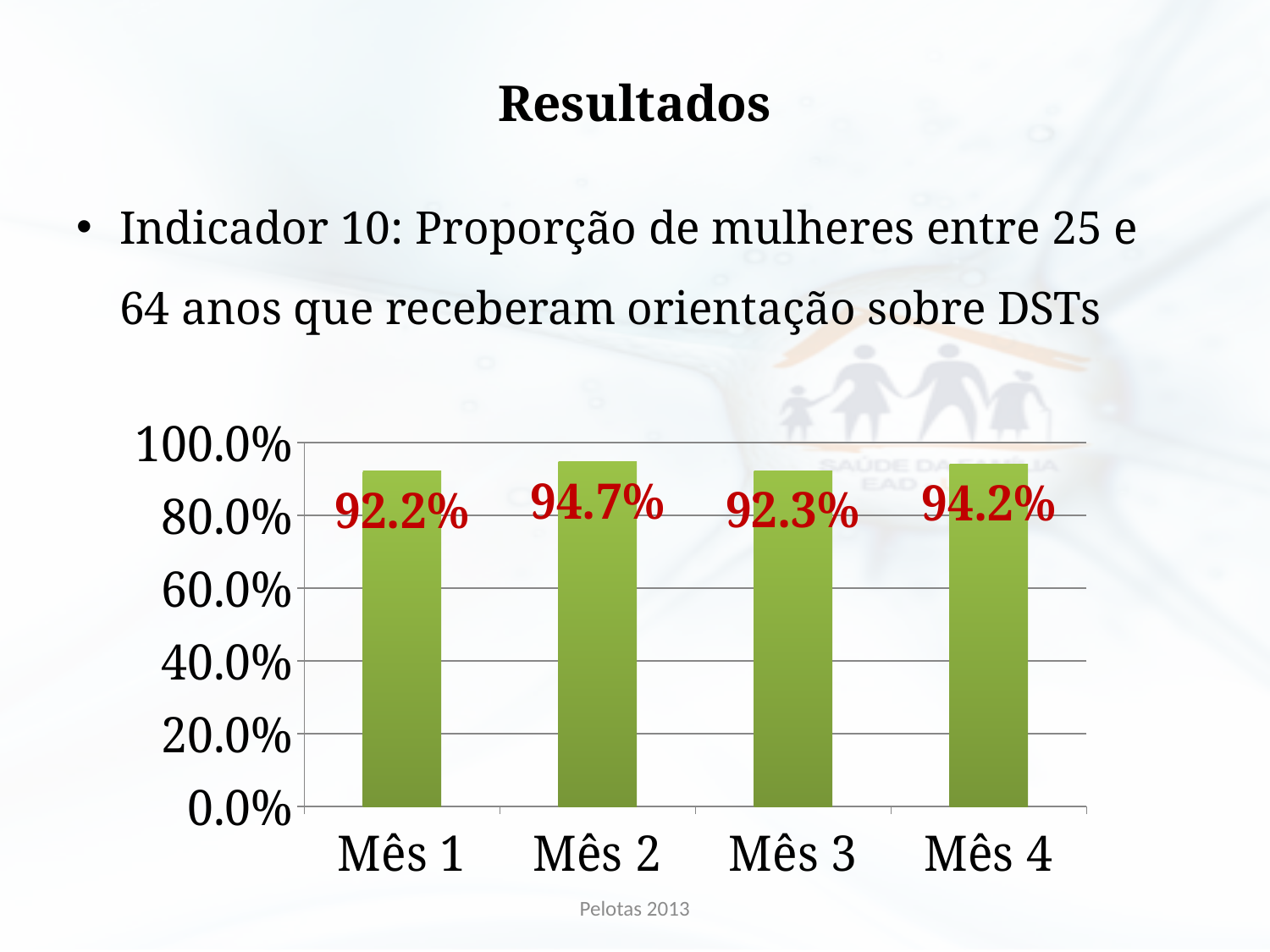
What is the difference between the values for Mês 4 and Mês 3? 1.9% What is the value for Mês 4? 94.2% Which is larger, the value for Mês 2 or the value for Mês 3? Mês 2 How many months are shown on the x axis? 4 What is the value for Mês 1? 92.2% What is the difference between the values for Mês 2 and Mês 1? 2.5% Is the value for Mês 3 greater or less than 80.0%? greater What is the value for Mês 3? 92.3% Which month has the lowest value? Mês 1 What is the value for Mês 2? 94.7% What kind of chart is shown on the slide? bar chart Which month has the highest value? Mês 2